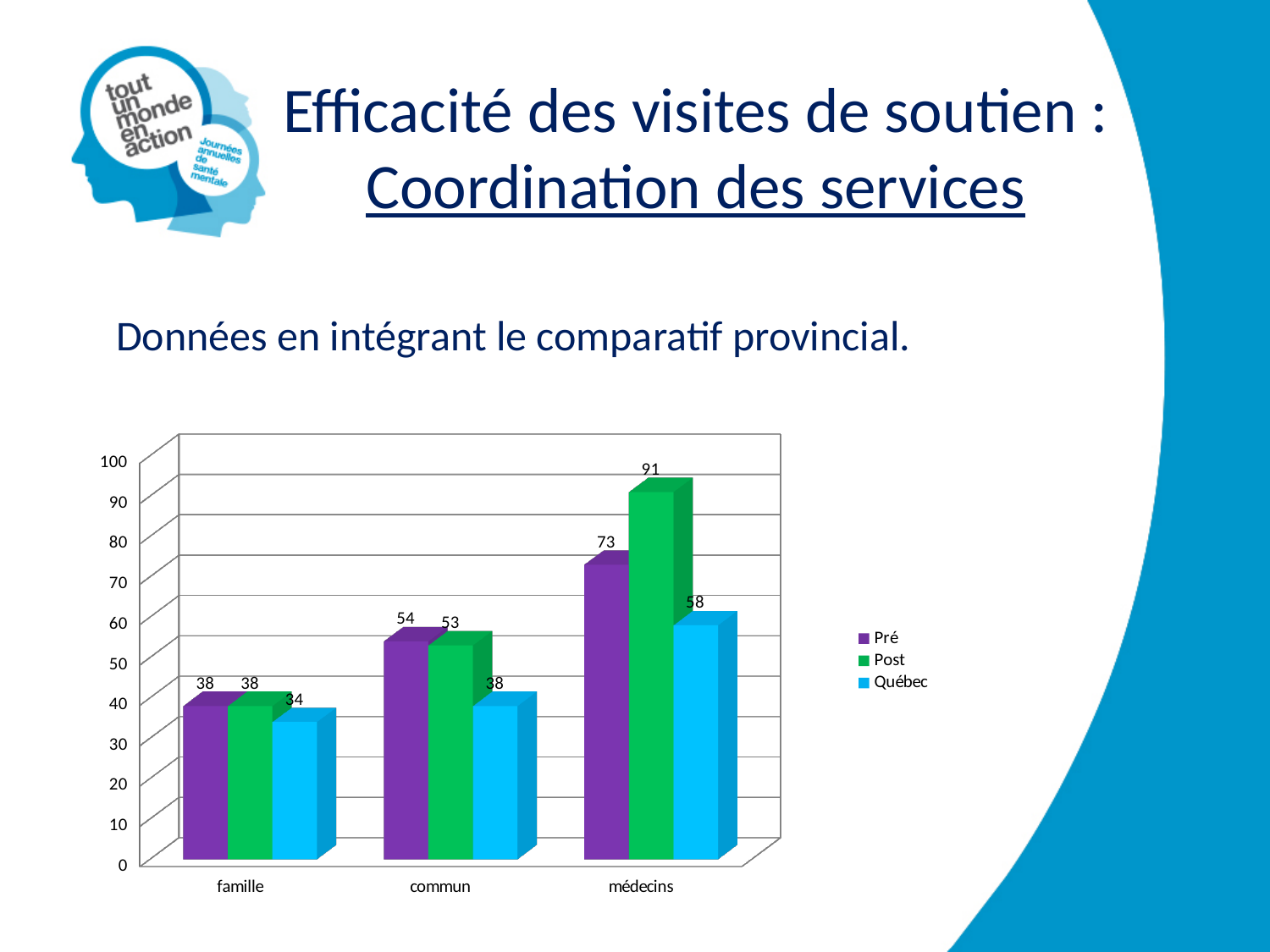
How many series does the legend list? 3 What is the Pré value for commun? 54 What is the Québec value for famille? 34 What is the difference between the Post and Pré values for médecins? 18 Which category has the lowest Québec value? famille What kind of chart is shown on the slide? bar chart Which colour represents the Québec series in the legend? light blue Which is larger for commun: the Pré value or the Québec value? Pré What is the Post value for médecins? 91 Is the Québec value for médecins greater or less than 50? greater Which category has the highest Post value? médecins How many categories are shown on the x axis? 3